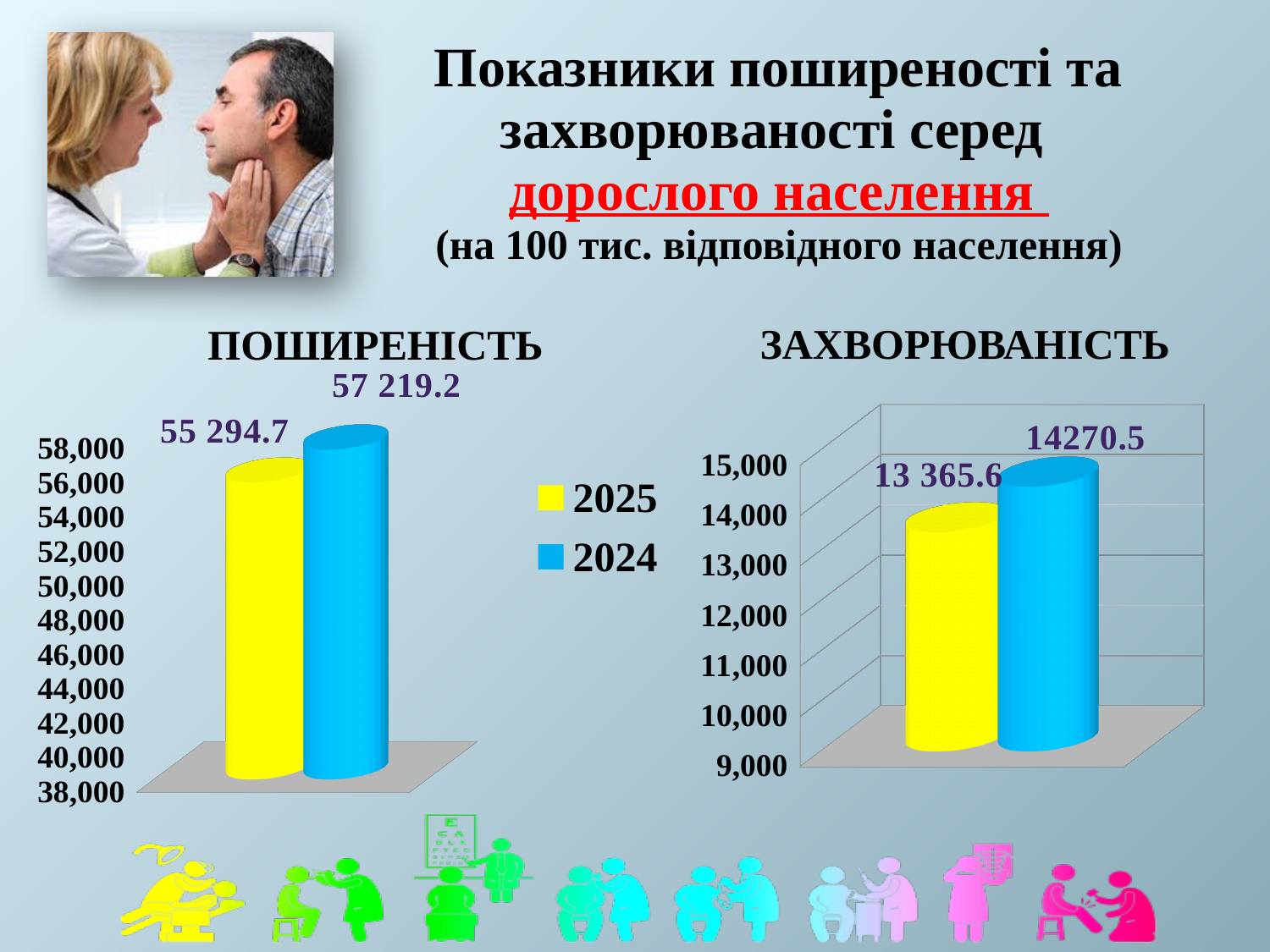
What kind of chart is the ПОШИРЕНІСТЬ chart? bar chart Which colour represents 2024 in the legend? blue In the ЗАХВОРЮВАНІСТЬ chart, is the value for 2025 greater or less than 14,000? less In the ЗАХВОРЮВАНІСТЬ chart, what is the difference between the 2024 and 2025 values? 904.9 In the ЗАХВОРЮВАНІСТЬ chart, what is the value for 2025? 13 365.6 In the ПОШИРЕНІСТЬ chart, what is the value for 2024? 57 219.2 How many series does the legend list? 2 In the ПОШИРЕНІСТЬ chart, what is the value for 2025? 55 294.7 In the ЗАХВОРЮВАНІСТЬ chart, which year has the lower value? 2025 In the ЗАХВОРЮВАНІСТЬ chart, what is the value for 2024? 14270.5 In the ПОШИРЕНІСТЬ chart, what is the difference between the 2024 and 2025 values? 1 924.5 In the ПОШИРЕНІСТЬ chart, which year has the higher value? 2024